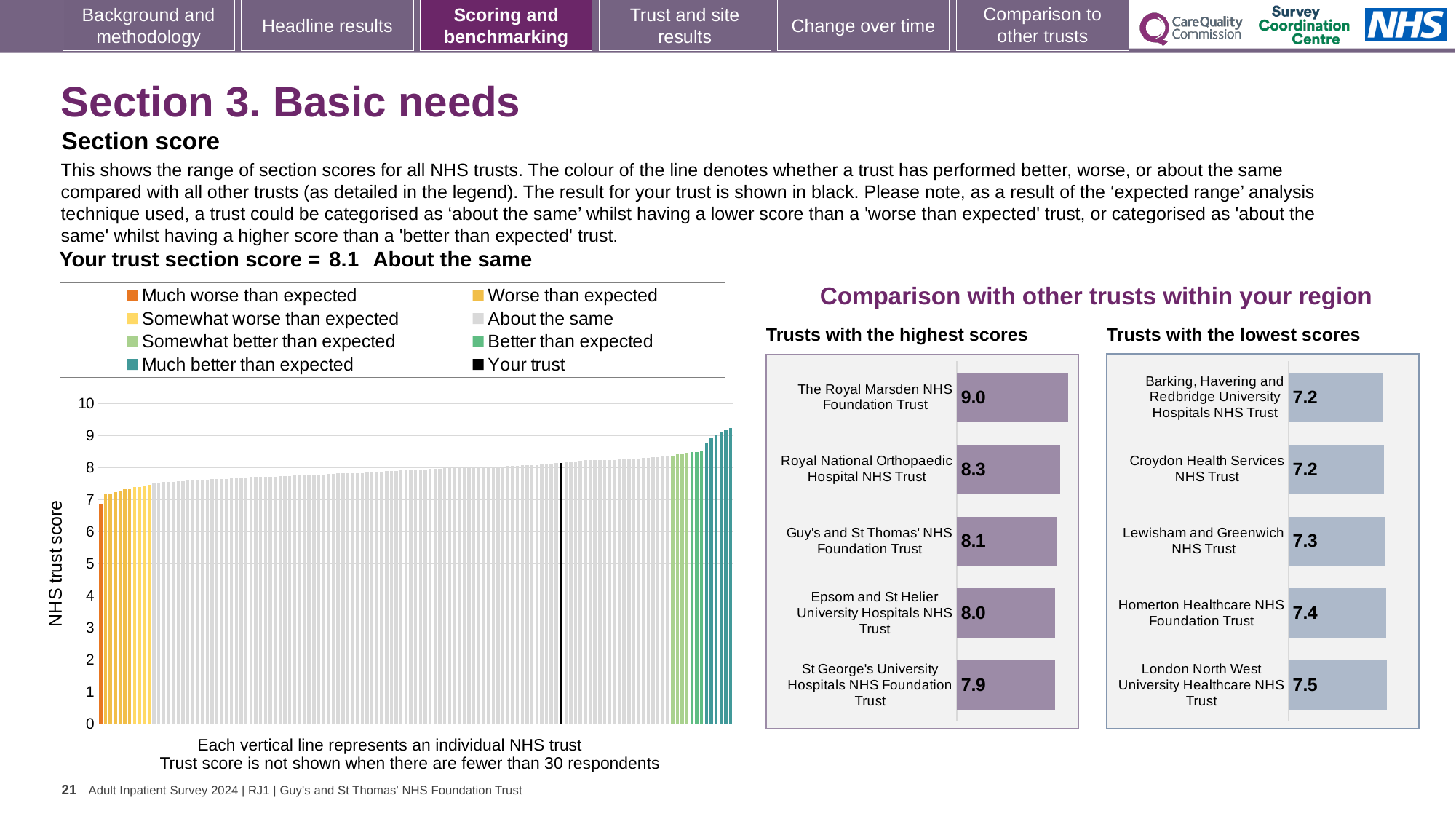
On the 'Trusts with the lowest scores' chart, what is the score for Homerton Healthcare NHS Foundation Trust? 7.4 How many trusts are shown on the 'Trusts with the highest scores' chart? 5 How many entries does the legend of the main NHS trust score chart list? 8 On the 'Trusts with the highest scores' chart, what is the score for The Royal Marsden NHS Foundation Trust? 9.0 On the 'Trusts with the lowest scores' chart, which trust has the highest score? London North West University Healthcare NHS Trust On the 'Trusts with the highest scores' chart, what is the score for St George's University Hospitals NHS Foundation Trust? 7.9 On the 'Trusts with the lowest scores' chart, which has the higher score: Homerton Healthcare NHS Foundation Trust or Lewisham and Greenwich NHS Trust? Homerton Healthcare NHS Foundation Trust On the 'Trusts with the lowest scores' chart, what is the difference between the scores of London North West University Healthcare NHS Trust and Croydon Health Services NHS Trust? 0.3 On the 'Trusts with the highest scores' chart, what is the difference between the scores of The Royal Marsden NHS Foundation Trust and St George's University Hospitals NHS Foundation Trust? 1.1 On the main NHS trust score chart, do the bar values rise or fall from left to right? Rise What kind of chart is the main chart showing NHS trust scores on the left of the slide? Bar chart On the 'Trusts with the highest scores' chart, which trust has the highest score? The Royal Marsden NHS Foundation Trust